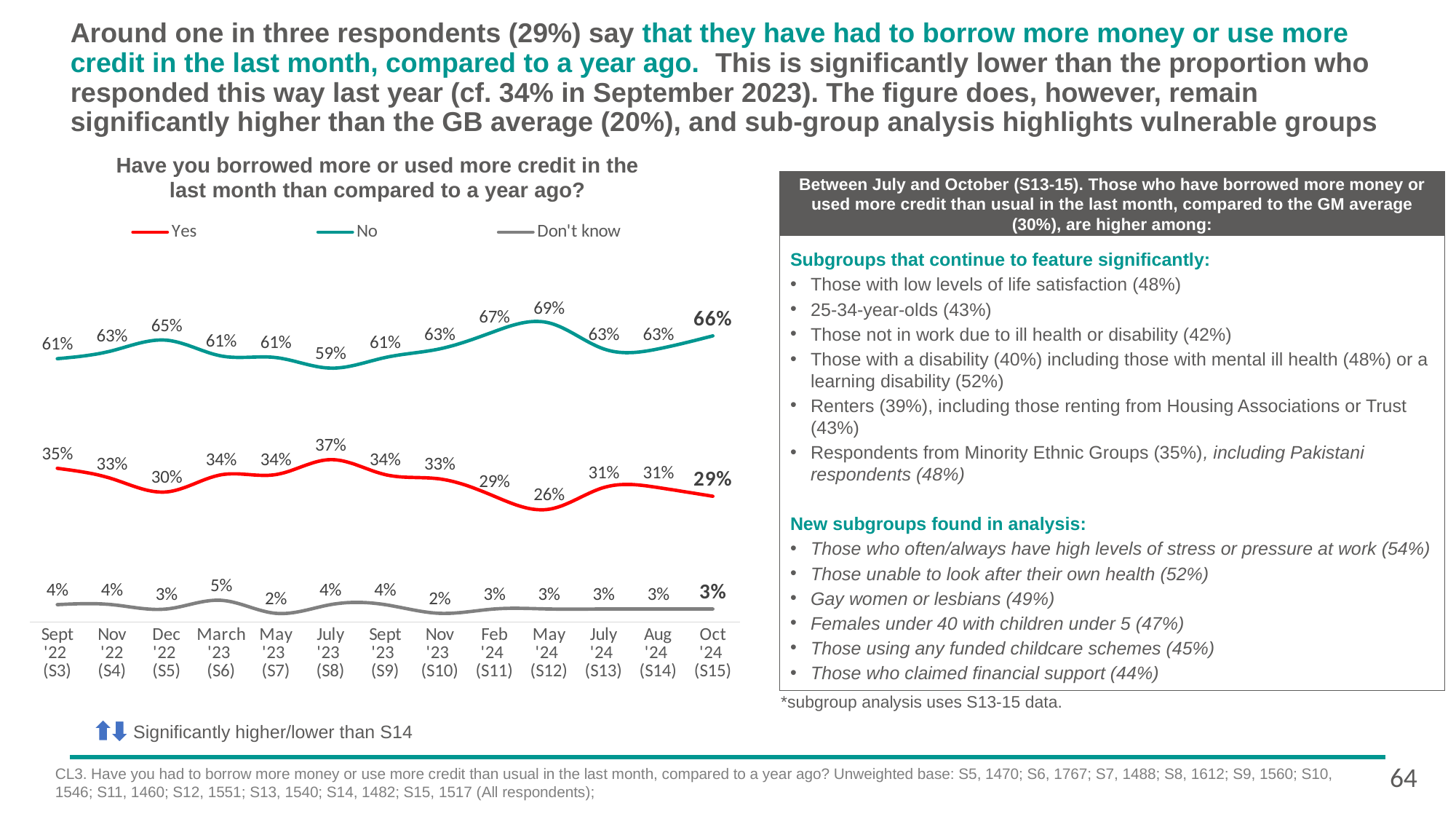
At which time point does the 'No' series reach its lowest value? July '23 (S8) What is the value of the 'No' series for May '24 (S12)? 69% What kind of chart is shown on the slide? Line chart Which series is shown in red on the chart? Yes What is the value of the 'Yes' series for Oct '24 (S15)? 29% How many series does the chart legend list? 3 What is the value of the 'Don't know' series for March '23 (S6)? 5% At which time point does the 'Yes' series reach its lowest value? May '24 (S12) How many time points are plotted along the x axis of the chart? 13 Which is larger: the 'No' value for Feb '24 (S11) or the 'No' value for Oct '24 (S15)? Feb '24 (S11) What is the difference between the 'Yes' value for Sept '22 (S3) and the 'Yes' value for Oct '24 (S15)? 6 percentage points At which time point does the 'Yes' series reach its highest value? July '23 (S8)